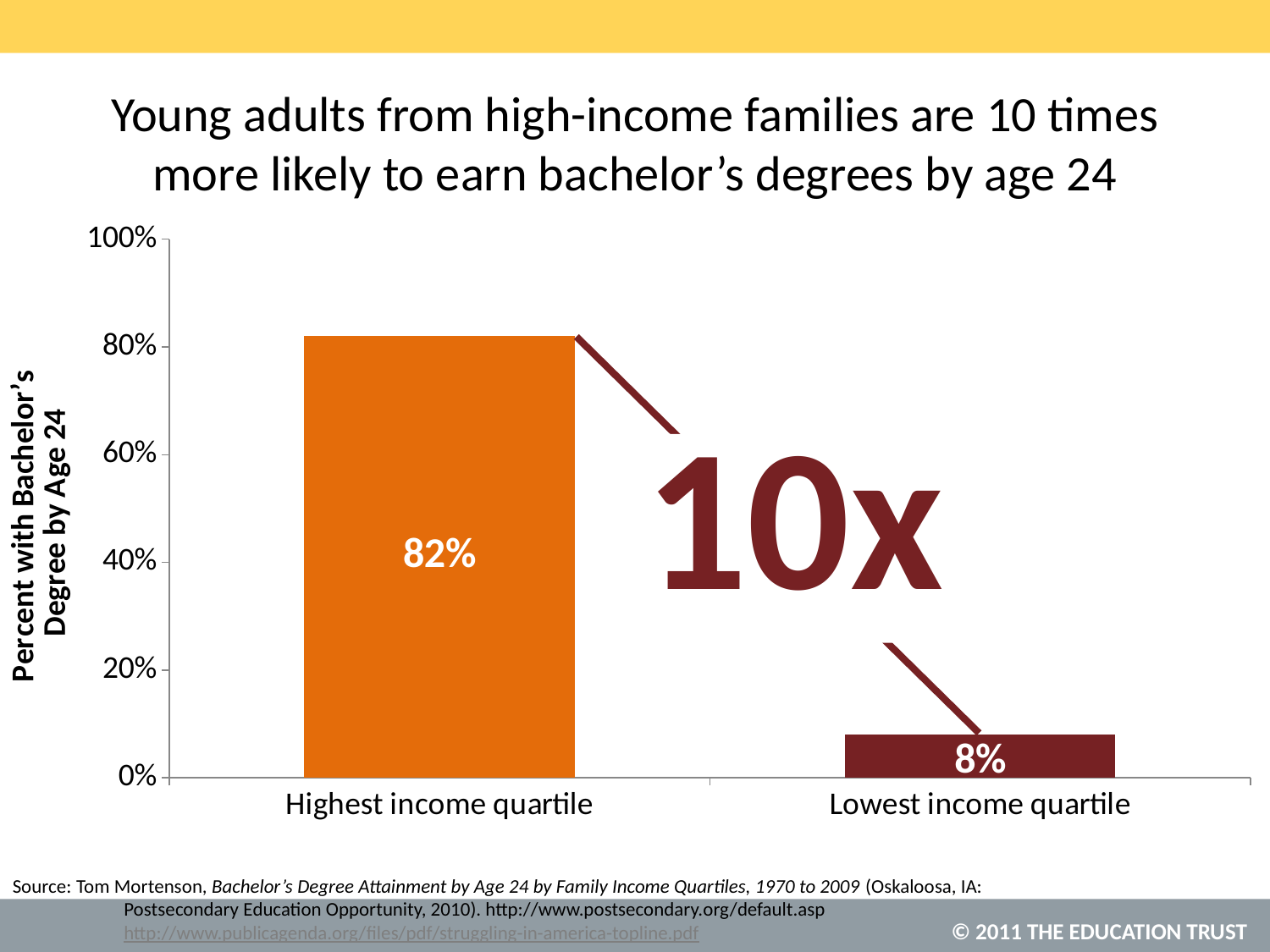
What is the value for Lowest income quartile? 8% What is the value for Highest income quartile? 82% Is the value for Highest income quartile greater or less than 60%? greater Is the value for Lowest income quartile greater or less than 20%? less What is the label of the y axis? Percent with Bachelor's Degree by Age 24 Which category has the highest value? Highest income quartile What is the difference between the values for Highest income quartile and Lowest income quartile? 74% What large annotation is printed between the two bars? 10x Which is larger, the value for Highest income quartile or Lowest income quartile? Highest income quartile How many categories are shown on the x axis? 2 Which category has the lowest value? Lowest income quartile What kind of chart is shown on the slide? Bar chart